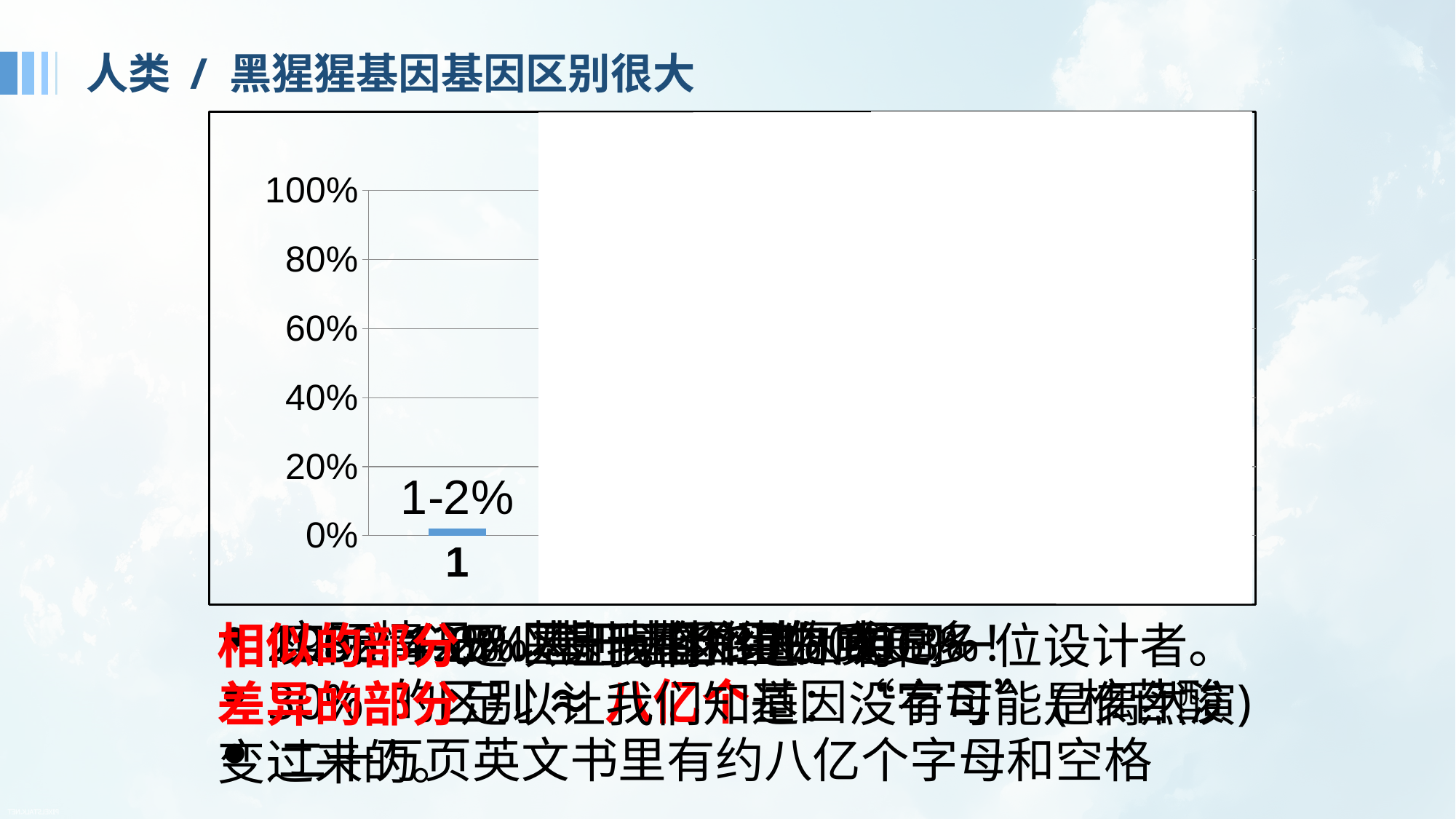
What is the highest value shown on the vertical axis of the chart? 100% How many bars are plotted in the chart? 1 What is the category label printed under the bar? 1 What data label is printed above the bar for category 1? 1-2% What kind of chart is shown on the slide? bar chart Is the value for category 1 greater or less than 20%? less